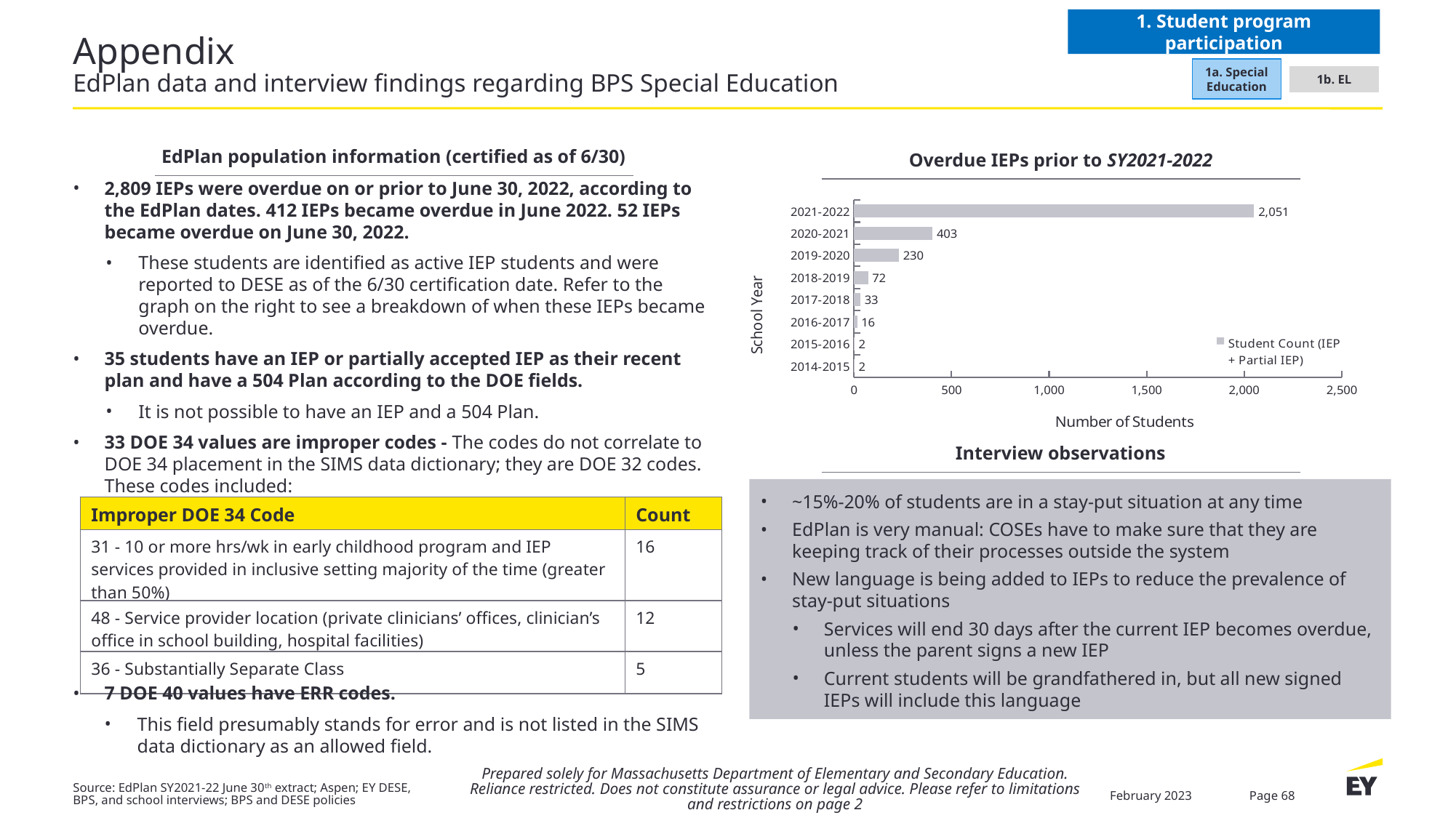
What is the value for 2019-2020 in the Overdue IEPs chart? 230 Which is larger in the Overdue IEPs chart, the value for 2018-2019 or the value for 2016-2017? 2018-2019 How many series does the legend of the Overdue IEPs chart list? 1 What is the value for 2021-2022 in the Overdue IEPs prior to SY2021-2022 chart? 2,051 What is the legend entry in the Overdue IEPs chart? Student Count (IEP + Partial IEP) What is the value for 2017-2018 in the Overdue IEPs chart? 33 How many school years are shown in the Overdue IEPs chart? 8 What kind of chart is the Overdue IEPs prior to SY2021-2022 chart? bar chart What is the difference between the values for 2020-2021 and 2019-2020 in the Overdue IEPs chart? 173 Is the value for 2020-2021 in the Overdue IEPs chart greater or less than 500? less What is the x-axis label of the Overdue IEPs chart? Number of Students Which school year has the highest number of overdue IEPs in the chart? 2021-2022